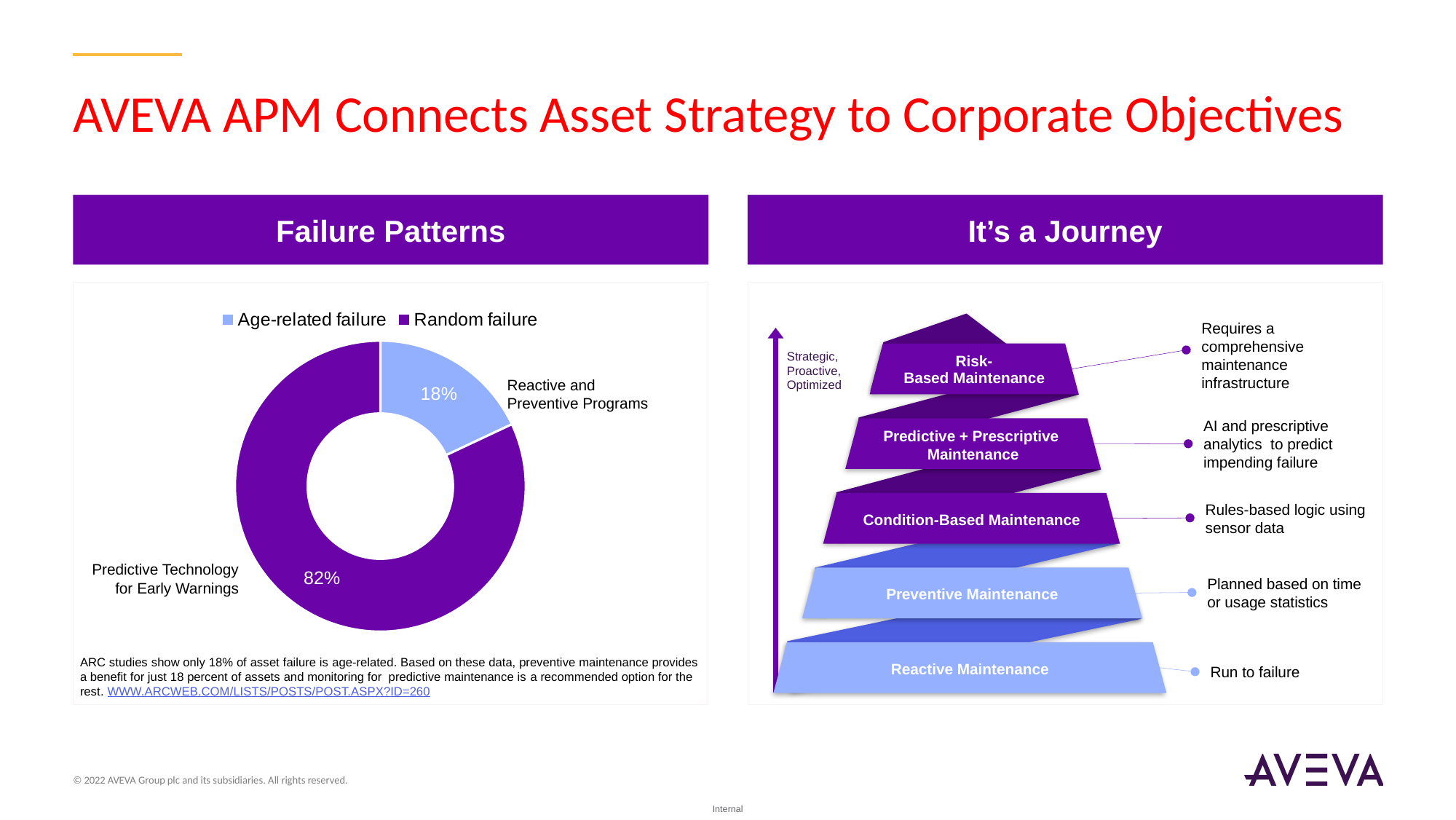
In the doughnut chart, which is larger: age-related failure or random failure? Random failure How many slices does the doughnut chart have? 2 What colour is the random failure slice in the doughnut chart? Purple Which legend entry in the doughnut chart is shown in light blue? Age-related failure What kind of chart is shown under the "Failure Patterns" heading? Doughnut chart Which slice of the doughnut chart is the largest? Random failure Is the value for random failure in the doughnut chart greater or less than 50%? greater Which slice of the doughnut chart is the smallest? Age-related failure What is the difference in percentage points between the random failure and age-related failure slices in the doughnut chart? 64 What percentage of asset failure is shown as random failure in the doughnut chart? 82% What percentage of asset failure is shown as age-related in the doughnut chart? 18% How many entries does the legend of the doughnut chart list? 2